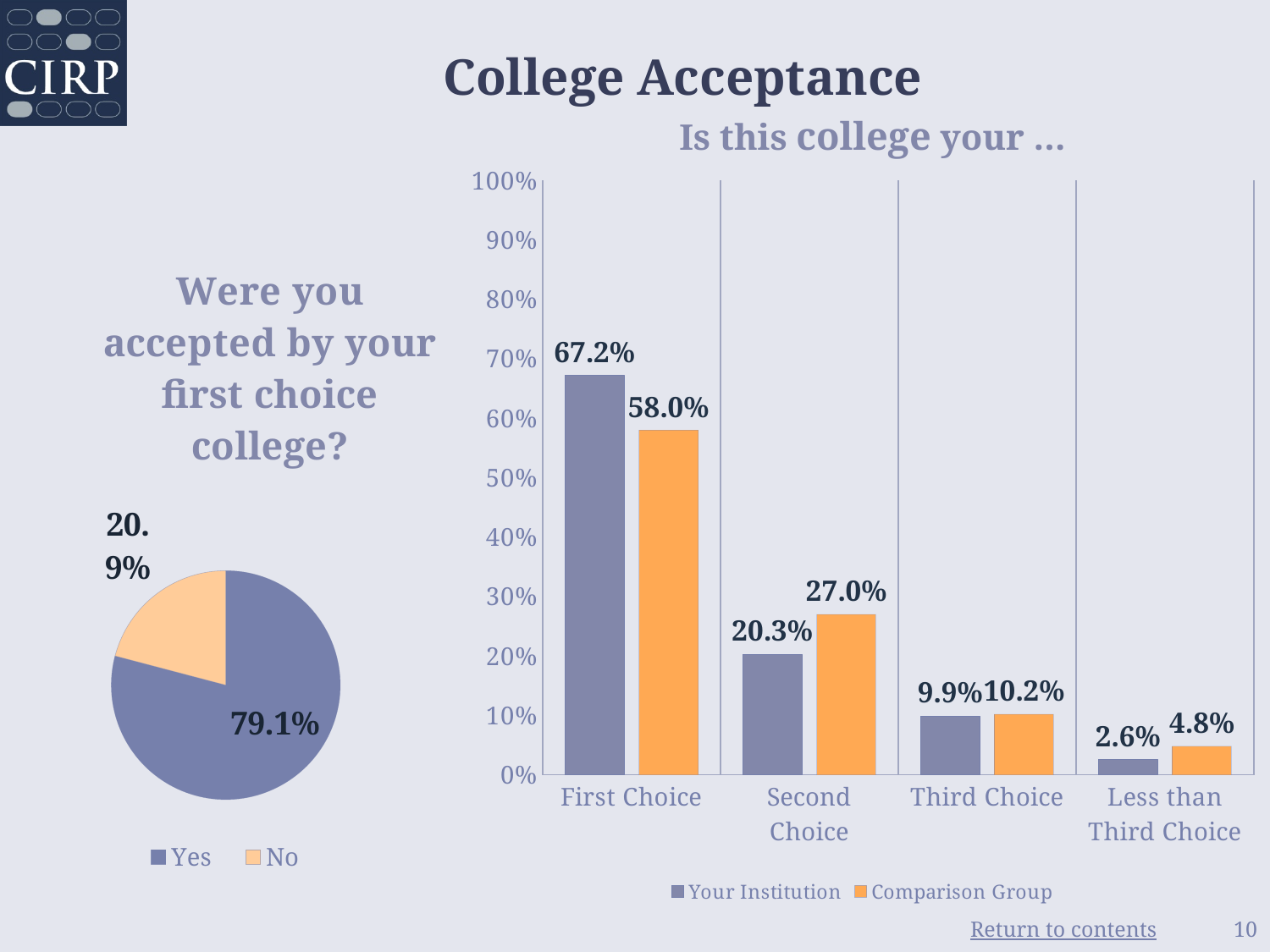
How many categories are shown on the x axis of the bar chart 'Is this college your ...'? 4 In the bar chart 'Is this college your ...', what is the value for Comparison Group for Second Choice? 27.0% In the pie chart 'Were you accepted by your first choice college?', what percentage answered Yes? 79.1% In the bar chart 'Is this college your ...', which is larger for Second Choice: Your Institution or Comparison Group? Comparison Group In the bar chart 'Is this college your ...', which category has the lowest value for Your Institution? Less than Third Choice In the bar chart 'Is this college your ...', what is the value for Your Institution for First Choice? 67.2% In the bar chart 'Is this college your ...', what is the value for Your Institution for Less than Third Choice? 2.6% In the bar chart 'Is this college your ...', what is the difference between Your Institution and Comparison Group for First Choice? 9.2% What kind of chart is the chart on the left of the slide, titled 'Were you accepted by your first choice college?'? Pie chart How many series does the legend of the bar chart 'Is this college your ...' list? 2 In the bar chart 'Is this college your ...', which category has the highest value for Comparison Group? First Choice In the pie chart 'Were you accepted by your first choice college?', what percentage answered No? 20.9%